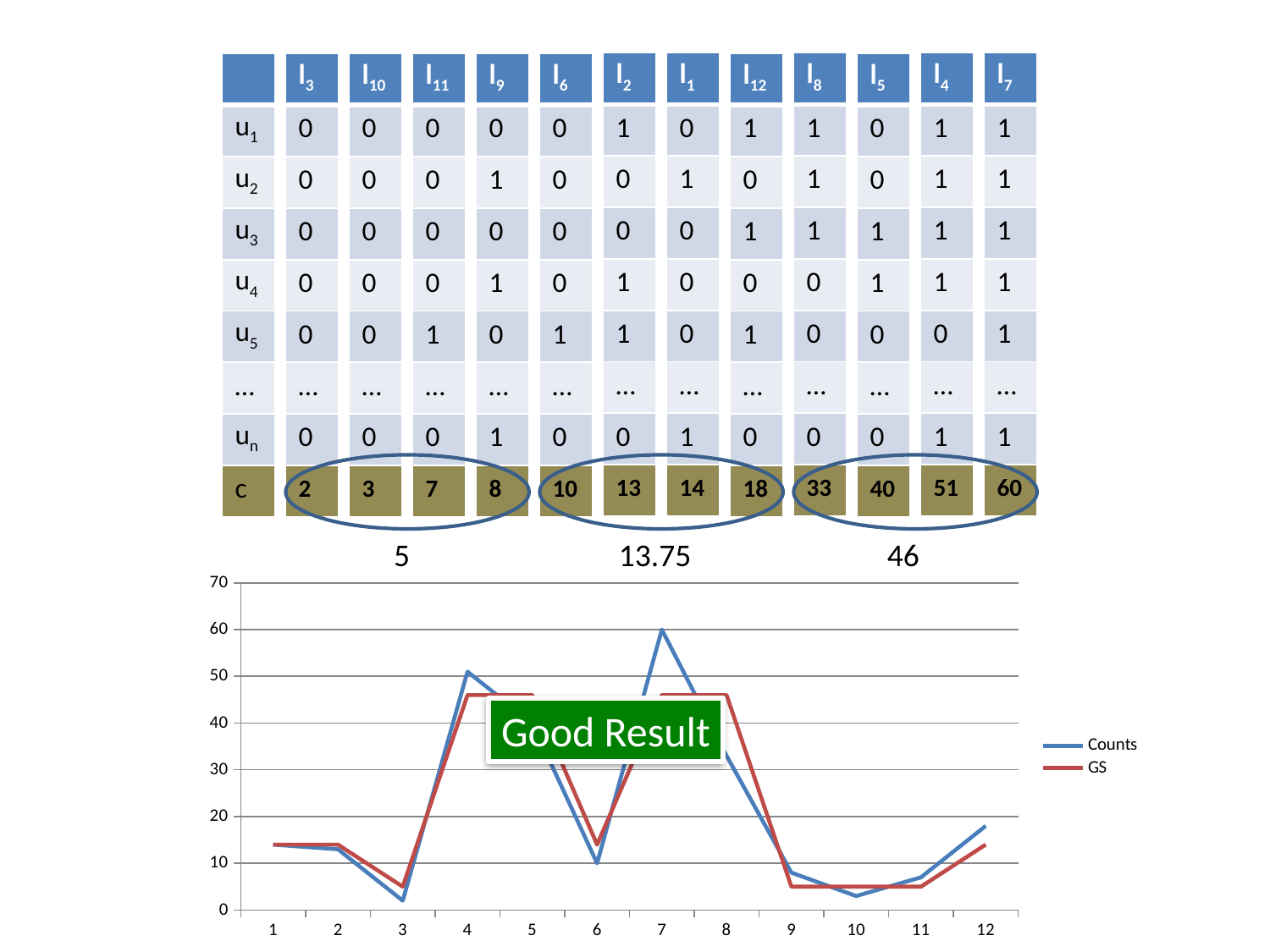
At which x-axis point does the Counts series reach its highest value? 7 What kind of chart is shown at the bottom of the slide? line chart Is the Counts value at x = 3 greater or less than 10? less At x = 3, which series has the larger value, Counts or GS? GS Does the Counts series rise or fall from x = 8 to x = 10? fall How many points are on the x axis of the line chart? 12 Is the Counts value at x = 7 greater or less than 50? greater Is the Counts value at x = 4 greater or less than 40? greater How many series does the chart legend list? 2 At x = 7, which series has the larger value, Counts or GS? Counts Which series is drawn with the blue line in the chart? Counts